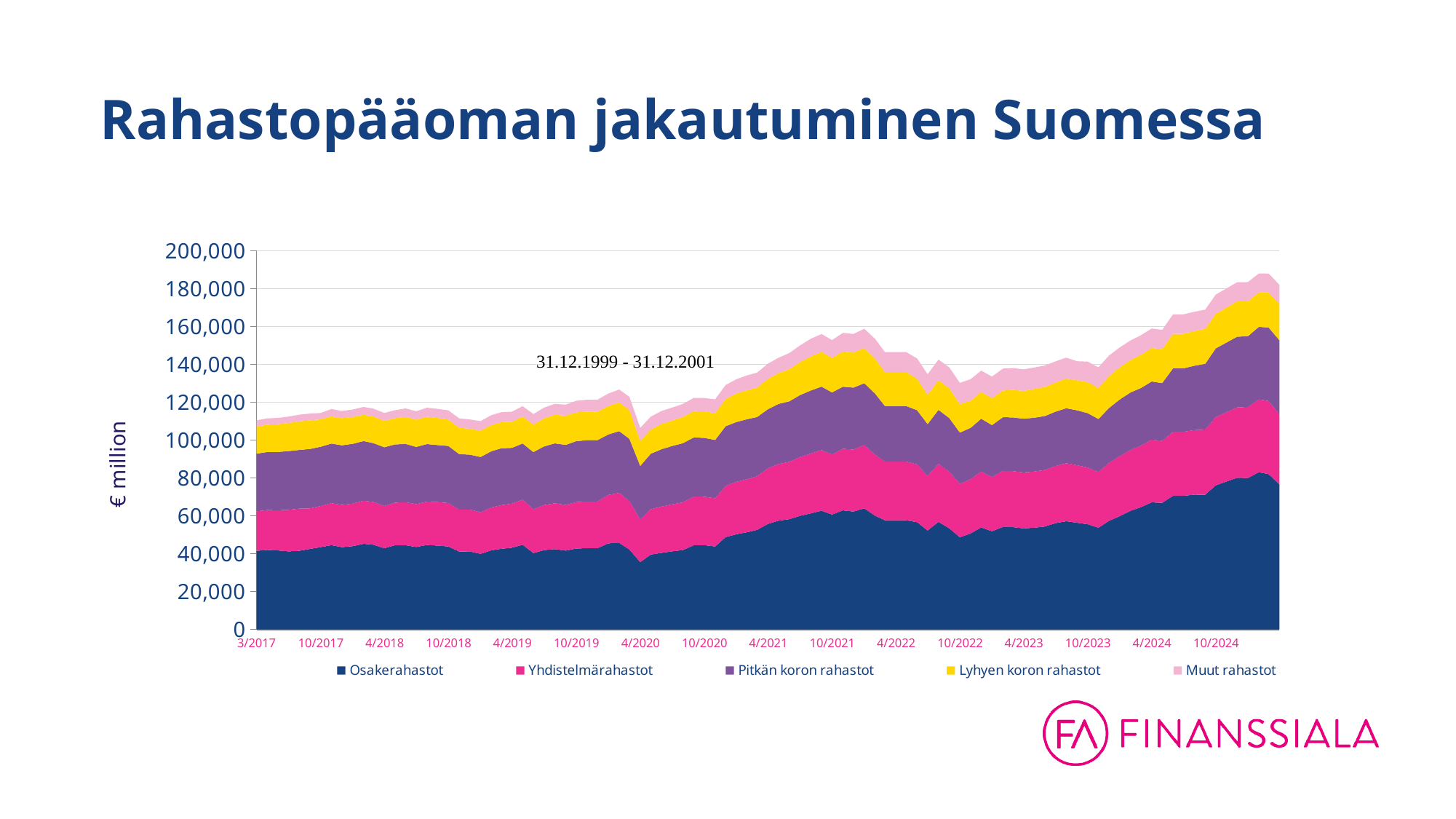
Is the value for Osakerahastot at 3/2017 greater or less than 60,000? less Which series is the smallest at the start of the chart (3/2017)? Muut rahastot How many series does the legend list? 5 What is the label on the vertical axis? € million What is the title of the chart? Rahastopääoman jakautuminen Suomessa At the right end of the chart, which is larger: Osakerahastot or Yhdistelmärahastot? Osakerahastot How many date labels are shown on the x axis? 16 Is the total stacked value at the right end of the chart greater or less than 160,000? greater Which series is the largest at the right end of the chart (latest date)? Osakerahastot Is the total stacked value at 3/2017 greater or less than 100,000? greater Does the total fund capital rise or fall overall from 3/2017 to the end of the chart? rise What kind of chart is shown on the slide? Stacked area chart